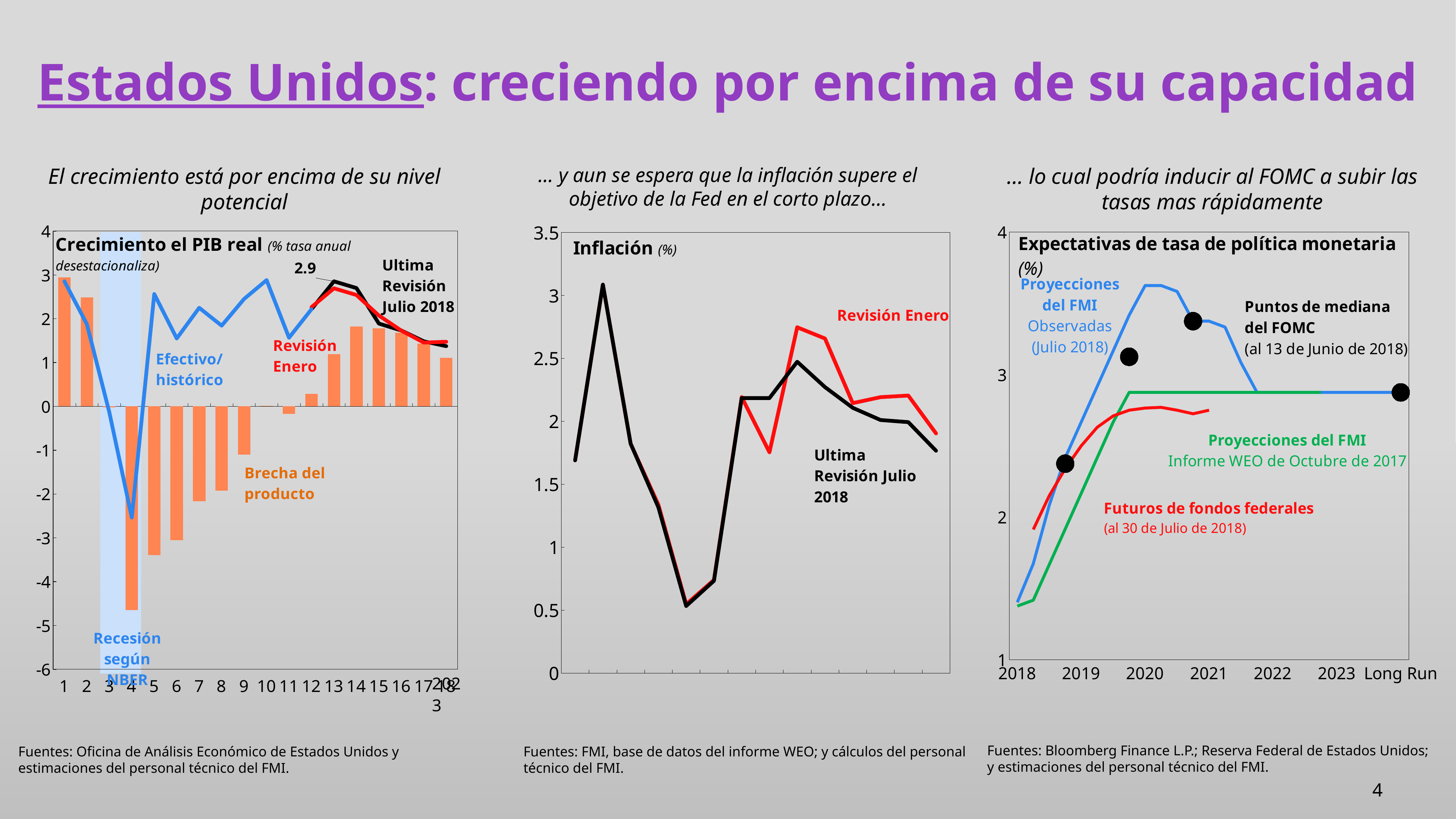
On the right chart 'Expectativas de tasa de política monetaria', how many series are labelled? 4 On the right chart 'Expectativas de tasa de política monetaria', how many 'Puntos de mediana del FOMC' dots are plotted? 4 On the left chart 'Crecimiento el PIB real', what value is printed as a data label on the 'Ultima Revisión Julio 2018' line? 2.9 On the middle chart 'Inflación', is the lowest point of the lines greater or less than 1? less On the middle chart 'Inflación', at the peak in the right half of the chart, which series is higher: 'Revisión Enero' or 'Ultima Revisión Julio 2018'? Revisión Enero On the left chart 'Crecimiento el PIB real', is the lowest 'Brecha del producto' bar greater or less than -4? less On the middle chart 'Inflación', how many series are labelled? 2 On the right chart 'Expectativas de tasa de política monetaria', what colour is the 'Futuros de fondos federales' line? red On the left chart 'Crecimiento el PIB real', what colour are the 'Brecha del producto' bars? orange What kind of chart is the middle chart titled 'Inflación (%)'? line chart On the right chart 'Expectativas de tasa de política monetaria', is the peak of the 'Proyecciones del FMI Observadas (Julio 2018)' line in 2020 greater or less than 3? greater On the right chart 'Expectativas de tasa de política monetaria', in 2020 which is higher: 'Proyecciones del FMI Observadas (Julio 2018)' or 'Proyecciones del FMI Informe WEO de Octubre de 2017'? Proyecciones del FMI Observadas (Julio 2018)